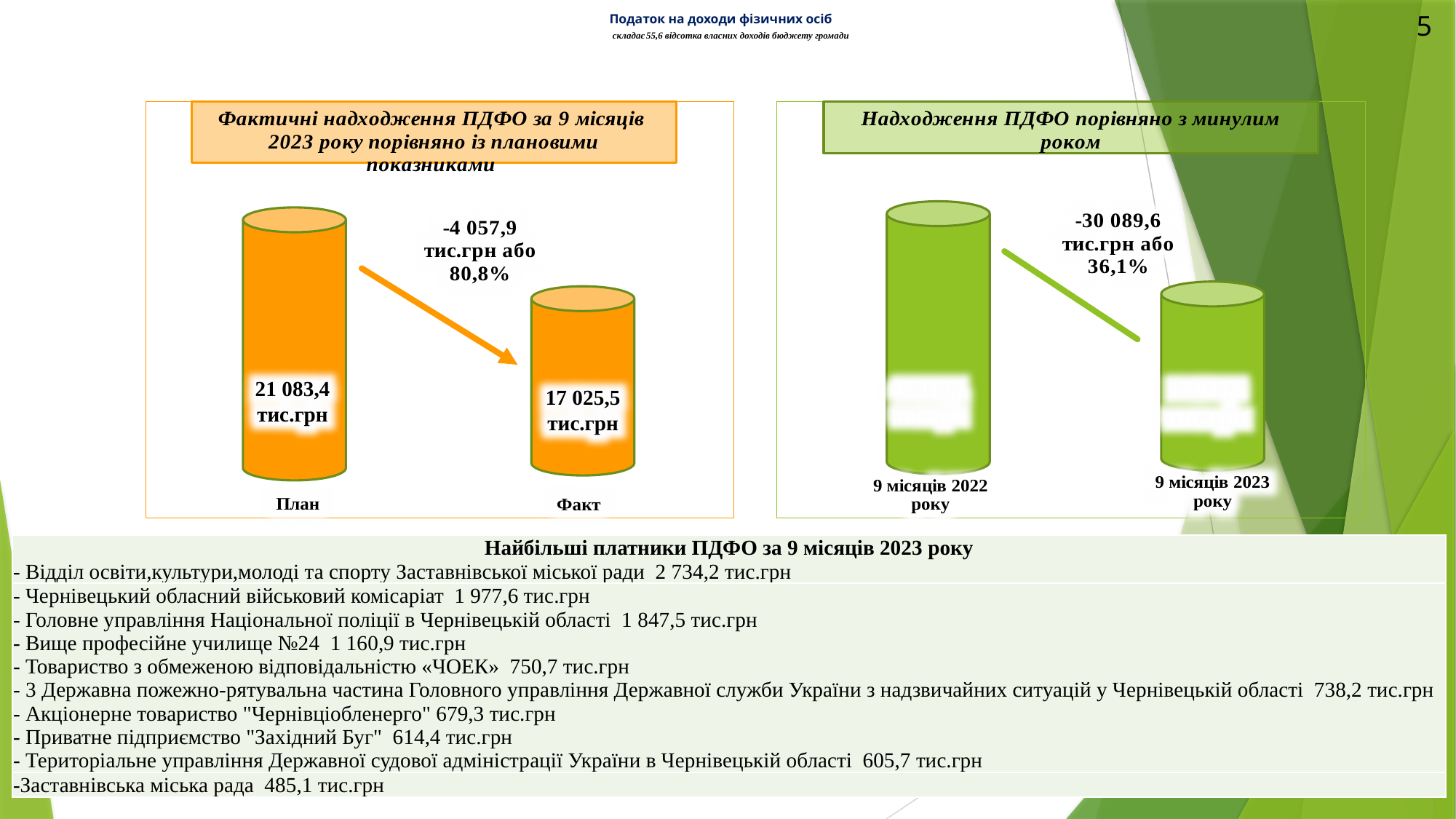
On the left chart, what percentage of the plan does the actual figure represent, as printed on the slide? 80,8% How many categories are shown on the right chart (Надходження ПДФО порівняно з минулим роком)? 2 How many categories are shown on the left chart? 2 On the right chart, which period has the larger value, 9 місяців 2022 року or 9 місяців 2023 року? 9 місяців 2022 року On the left chart (Фактичні надходження ПДФО за 9 місяців 2023 року), what is the value for Факт? 17 025,5 тис.грн What kind of chart is the left chart comparing План and Факт? bar chart On the left chart (Фактичні надходження ПДФО за 9 місяців 2023 року), what is the value for План? 21 083,4 тис.грн On the left chart, which category has the higher value, План or Факт? План On the left chart, which category has the lowest value? Факт On the left chart, what is the difference between Факт and План as printed on the slide? -4 057,9 тис.грн On the right chart (Надходження ПДФО порівняно з минулим роком), do the values rise or fall from 9 місяців 2022 року to 9 місяців 2023 року? fall On the right chart (Надходження ПДФО порівняно з минулим роком), what change between 2022 and 2023 is printed on the slide? -30 089,6 тис.грн або 36,1%